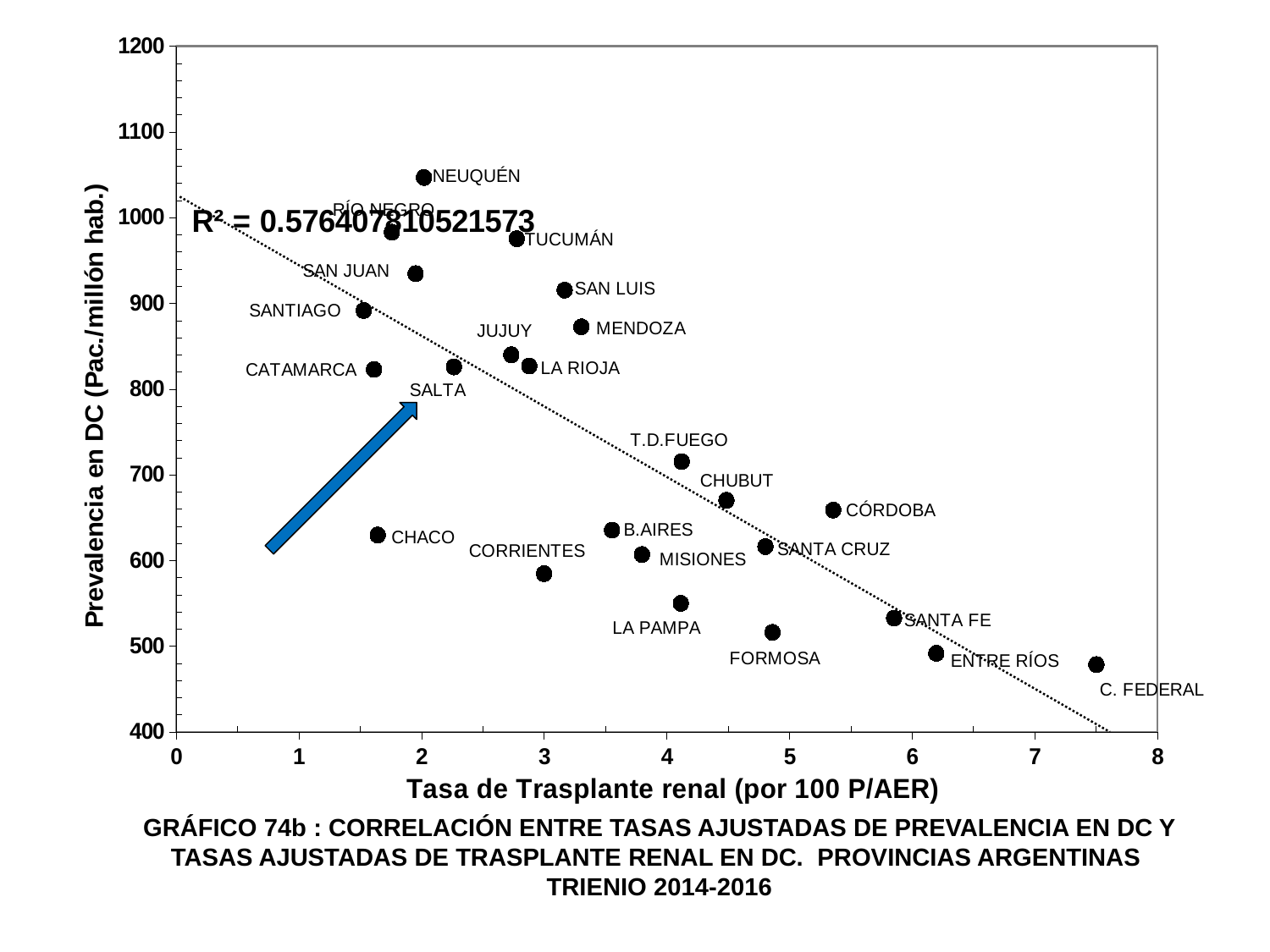
Is the prevalence value for C. FEDERAL greater or less than 500? less What R² value is printed on the chart? R² = 0.576407810521573 What is the label of the x axis? Tasa de Trasplante renal (por 100 P/AER) Is the prevalence value for LA PAMPA greater or less than 600? less As the renal transplant rate increases along the x axis, does prevalence in DC generally rise or fall according to the trend line? fall What kind of chart is shown on the slide? scatter plot Which has a higher prevalence in DC, SAN LUIS or CHUBUT? SAN LUIS Is the transplant rate for CÓRDOBA greater or less than 5? greater Which province has the highest prevalence in DC (Pac./millón hab.)? NEUQUÉN Which province has the highest renal transplant rate (Tasa de Trasplante renal)? C. FEDERAL Which province has the lowest prevalence in DC? C. FEDERAL